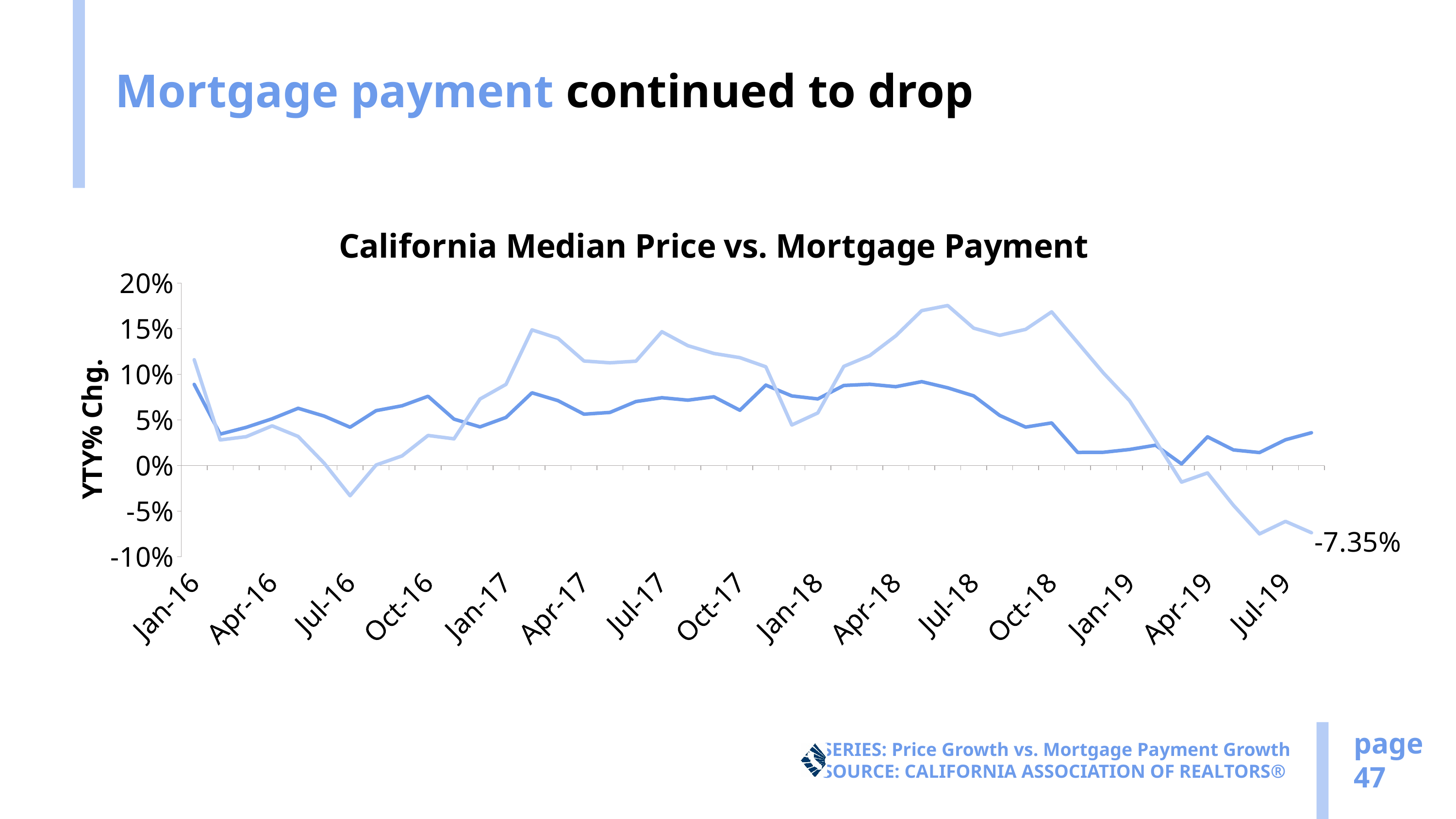
How many lines are plotted on the chart? 2 What is the label on the vertical axis of the chart? YTY% Chg. Does the lighter blue line rise or fall between Oct-18 and Jul-19? fall What kind of chart is shown on the slide? line chart What is the title of the chart? California Median Price vs. Mortgage Payment What value is printed at the end of the lighter blue line in Jul-19? -7.35% Is the value of the lighter blue line at Apr-17 greater or less than 10%? greater Is the value of the darker blue line at Jan-19 greater or less than 5%? less How many month labels are shown along the x axis? 15 At Jul-19, which line is higher, the darker blue line or the lighter blue line? the darker blue line Is the value of the lighter blue line at Jul-16 greater or less than 0%? less At Jul-18, which line is higher, the darker blue line or the lighter blue line? the lighter blue line